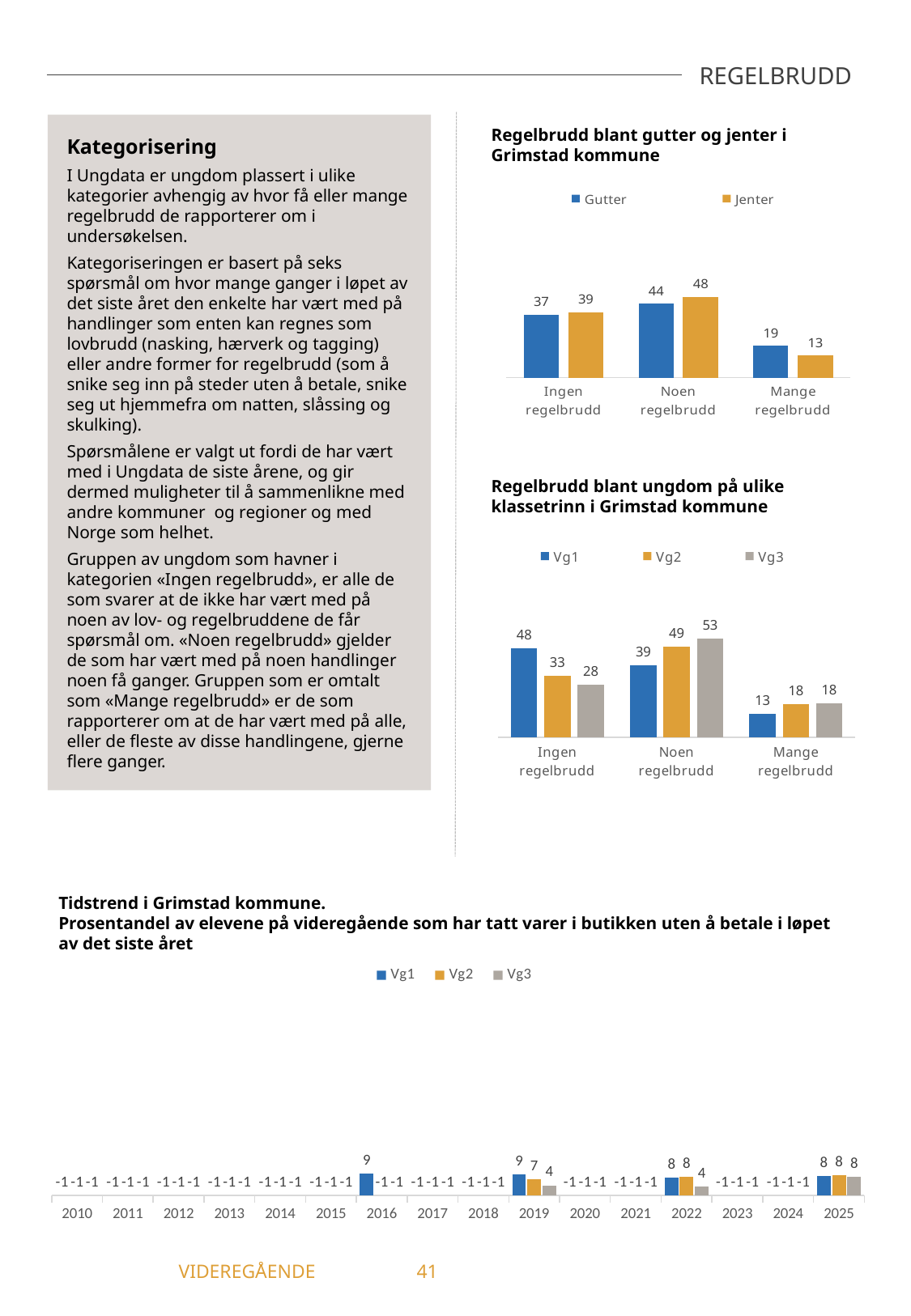
In the chart 'Regelbrudd blant ungdom på ulike klassetrinn i Grimstad kommune', what is the difference between Vg1 and Vg2 in the 'Mange regelbrudd' category? 5 In the chart 'Regelbrudd blant gutter og jenter i Grimstad kommune', what is the value for Gutter in the 'Mange regelbrudd' category? 19 In the chart 'Tidstrend i Grimstad kommune', what is the value for Vg3 in 2019? 4 What kind of chart is 'Tidstrend i Grimstad kommune'? Bar chart How many series does the legend list in the chart 'Regelbrudd blant gutter og jenter i Grimstad kommune'? 2 In the chart 'Regelbrudd blant gutter og jenter i Grimstad kommune', what is the difference between Gutter and Jenter in the 'Mange regelbrudd' category? 6 In the chart 'Regelbrudd blant ungdom på ulike klassetrinn i Grimstad kommune', which series has the lowest value in the 'Ingen regelbrudd' category? Vg3 In the chart 'Regelbrudd blant gutter og jenter i Grimstad kommune', which category has the highest value for Gutter? Noen regelbrudd In the chart 'Regelbrudd blant ungdom på ulike klassetrinn i Grimstad kommune', is the value for Vg2 or Vg3 larger in the 'Noen regelbrudd' category? Vg3 How many categories are shown on the x axis of the chart 'Regelbrudd blant ungdom på ulike klassetrinn i Grimstad kommune'? 3 In the chart 'Regelbrudd blant ungdom på ulike klassetrinn i Grimstad kommune', what is the value for Vg1 in the 'Ingen regelbrudd' category? 48 In the chart 'Regelbrudd blant gutter og jenter i Grimstad kommune', what is the value for Jenter in the 'Noen regelbrudd' category? 48